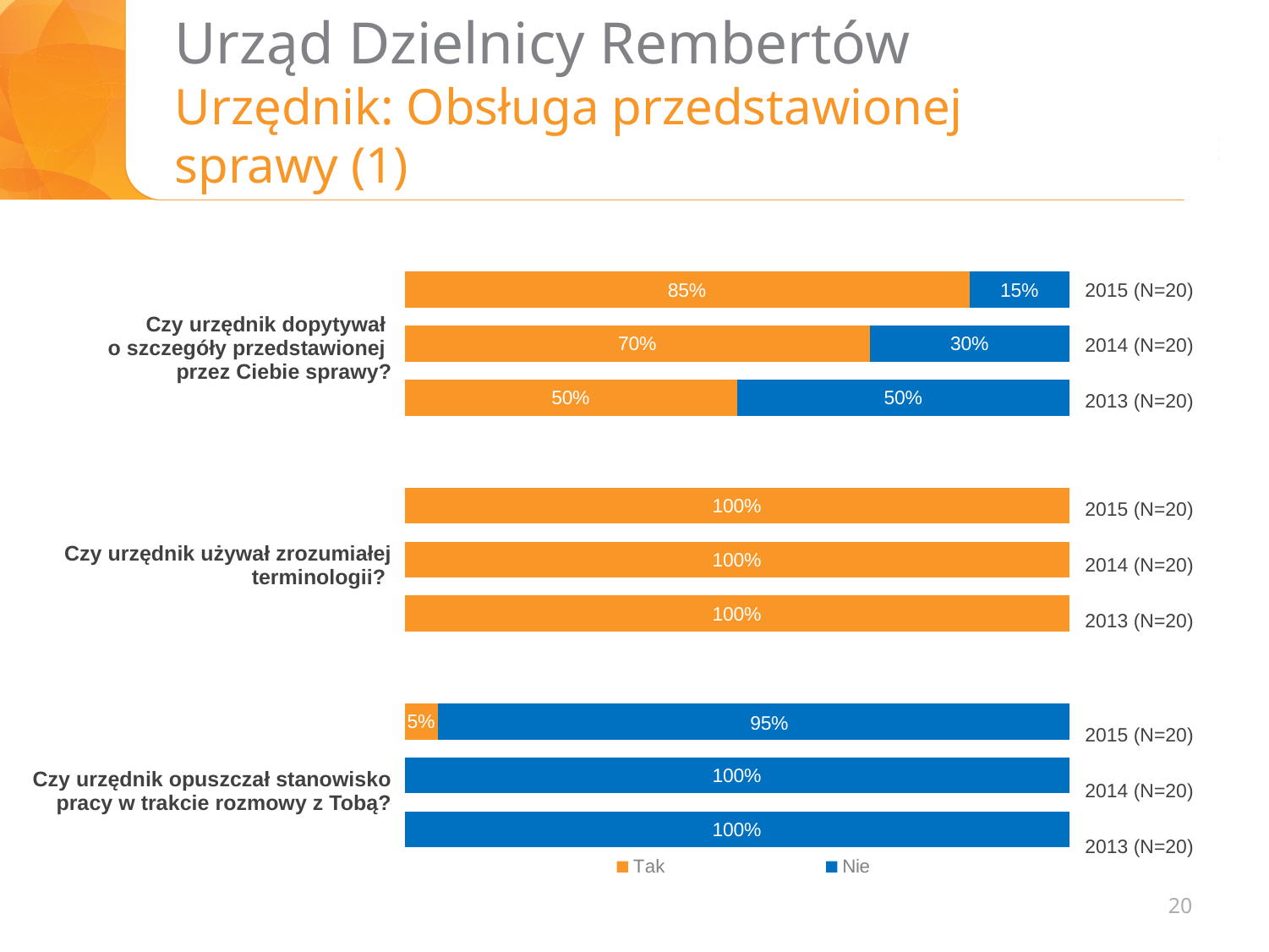
What is the sample size (N) shown for each year in the chart? N=20 What percentage answered "Nie" in 2015 to the question "Czy urzędnik opuszczał stanowisko pracy w trakcie rozmowy z Tobą?"? 95% What percentage answered "Tak" in 2015 to the question "Czy urzędnik dopytywał o szczegóły przedstawionej przez Ciebie sprawy?"? 85% For the question "Czy urzędnik dopytywał o szczegóły przedstawionej przez Ciebie sprawy?", what is the difference between the "Tak" share in 2015 and in 2014? 15 percentage points What percentage answered "Nie" in 2014 to the question "Czy urzędnik dopytywał o szczegóły przedstawionej przez Ciebie sprawy?"? 30% For the question "Czy urzędnik dopytywał o szczegóły przedstawionej przez Ciebie sprawy?", which year has the lowest "Tak" share? 2013 What percentage answered "Tak" in 2014 to the question "Czy urzędnik używał zrozumiałej terminologii?"? 100% What percentage answered "Tak" in 2013 to the question "Czy urzędnik dopytywał o szczegóły przedstawionej przez Ciebie sprawy?"? 50% How many series does the legend list? 2 For the question "Czy urzędnik dopytywał o szczegóły przedstawionej przez Ciebie sprawy?", which year has the highest "Tak" share? 2015 For the question "Czy urzędnik dopytywał o szczegóły przedstawionej przez Ciebie sprawy?", is the "Nie" share larger in 2014 or in 2015? 2014 What kind of chart is shown on the slide? Stacked bar chart